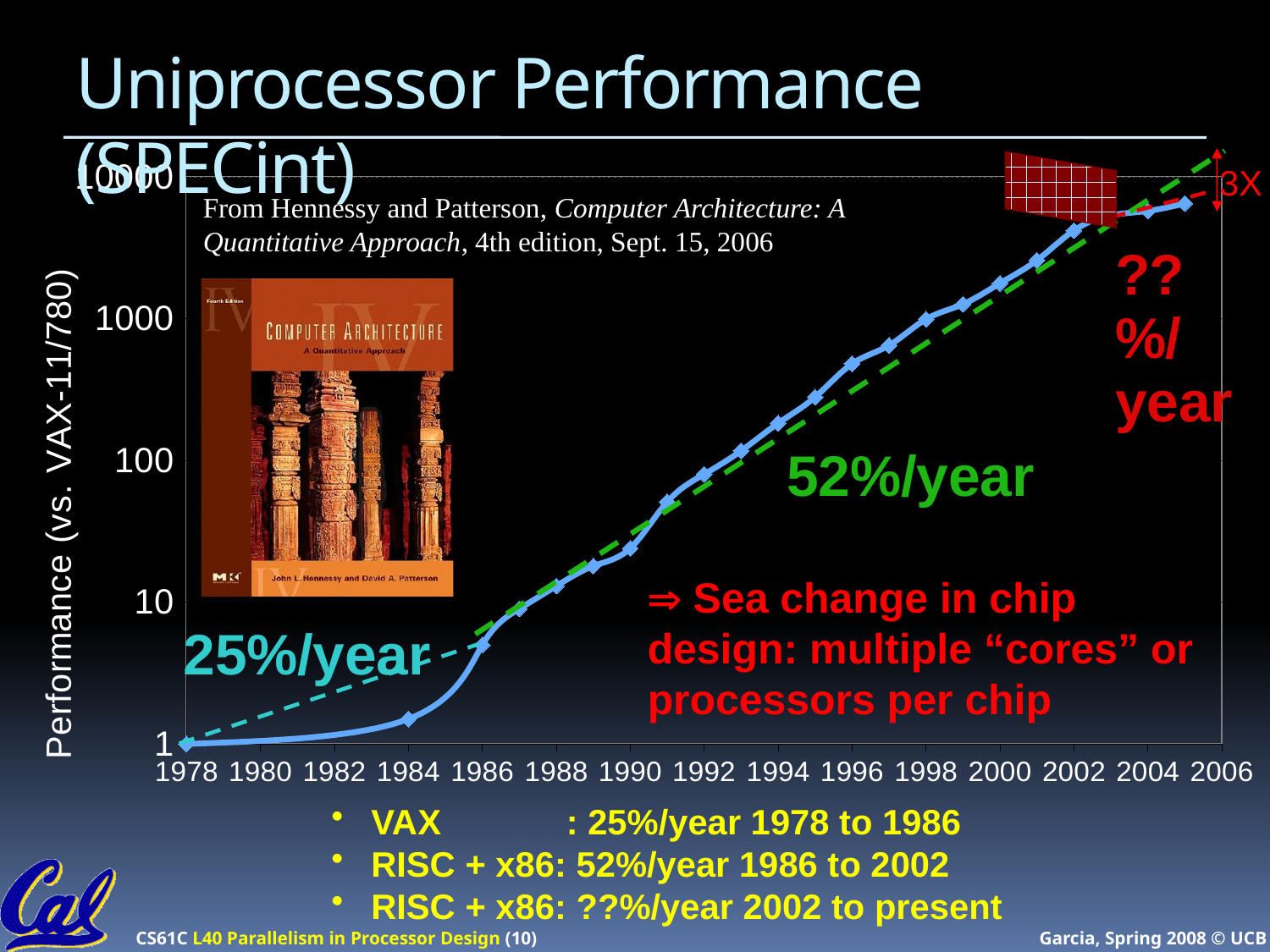
What is the performance value plotted for 1978? 1 What kind of chart is shown on the slide? line chart Is the performance value for 1994 greater or less than 100? greater Is the performance value for 1990 greater or less than 100? less Is the performance value for 2000 greater or less than 1000? greater Which year has the lowest plotted performance value? 1978 What annual growth rate is annotated on the chart for the period 1986 to 2002? 52%/year Do the plotted performance values rise or fall from 1978 to 2006? rise Which is larger, the performance value for 1996 or for 1988? 1996 What is the label on the y axis of the chart? Performance (vs. VAX-11/780)